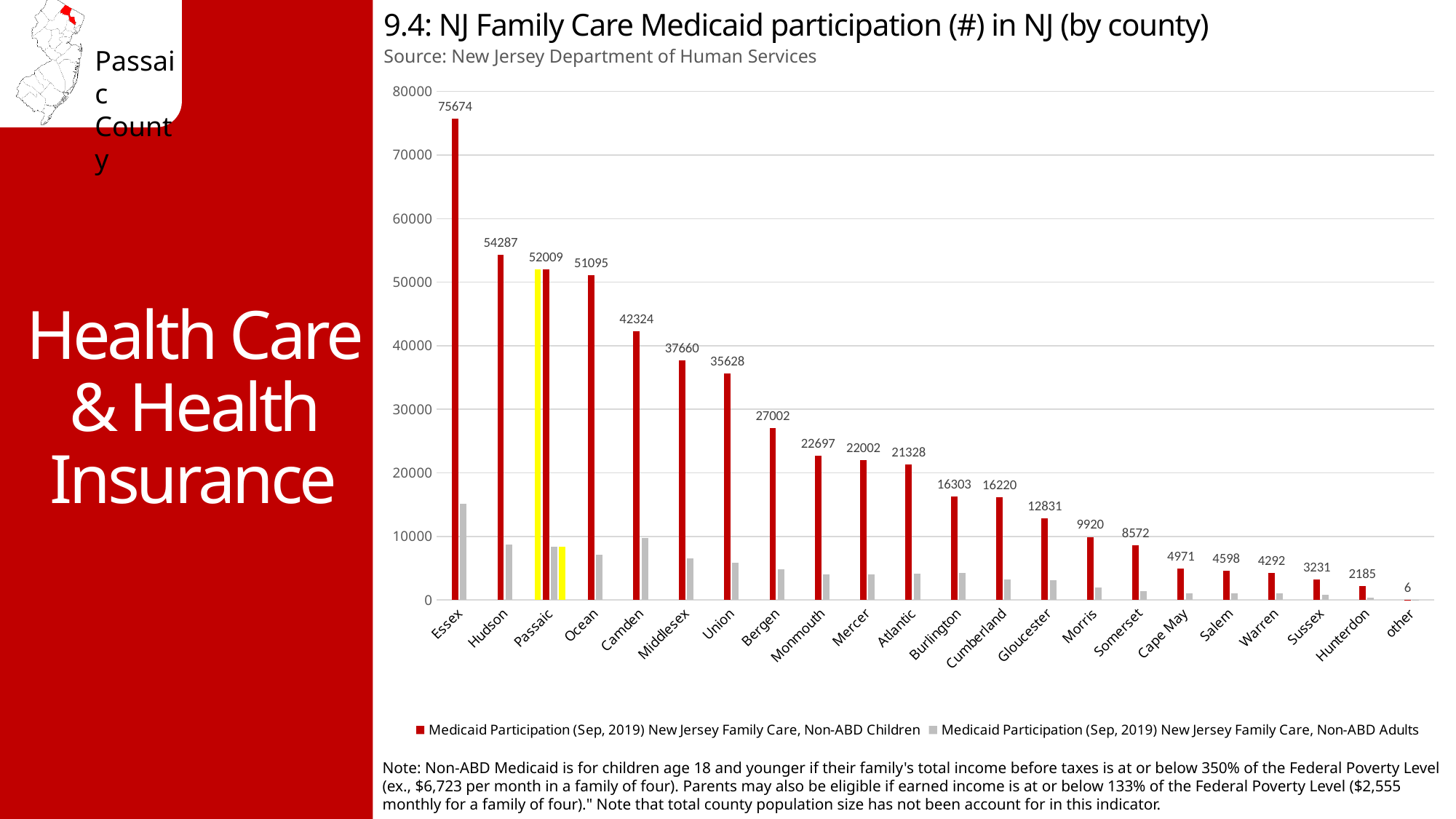
What kind of chart is shown on the slide? bar chart Which county has the highest Non-ABD Children Medicaid participation? Essex What is the source cited for the chart? New Jersey Department of Human Services Which has a larger Non-ABD Children value, Bergen or Monmouth? Bergen What is the Non-ABD Children Medicaid participation value for Camden? 42324 Which county (excluding 'other') has the lowest Non-ABD Children Medicaid participation? Hunterdon What is the Non-ABD Children Medicaid participation value for Passaic? 52009 How many series does the legend list? 2 Do the Non-ABD Children values rise or fall moving left to right along the x axis? fall How many counties/categories are shown on the x axis? 22 Is the Non-ABD Adults value for Essex greater or less than 10000? greater What is the difference between the Non-ABD Children values for Essex and Hudson? 21387